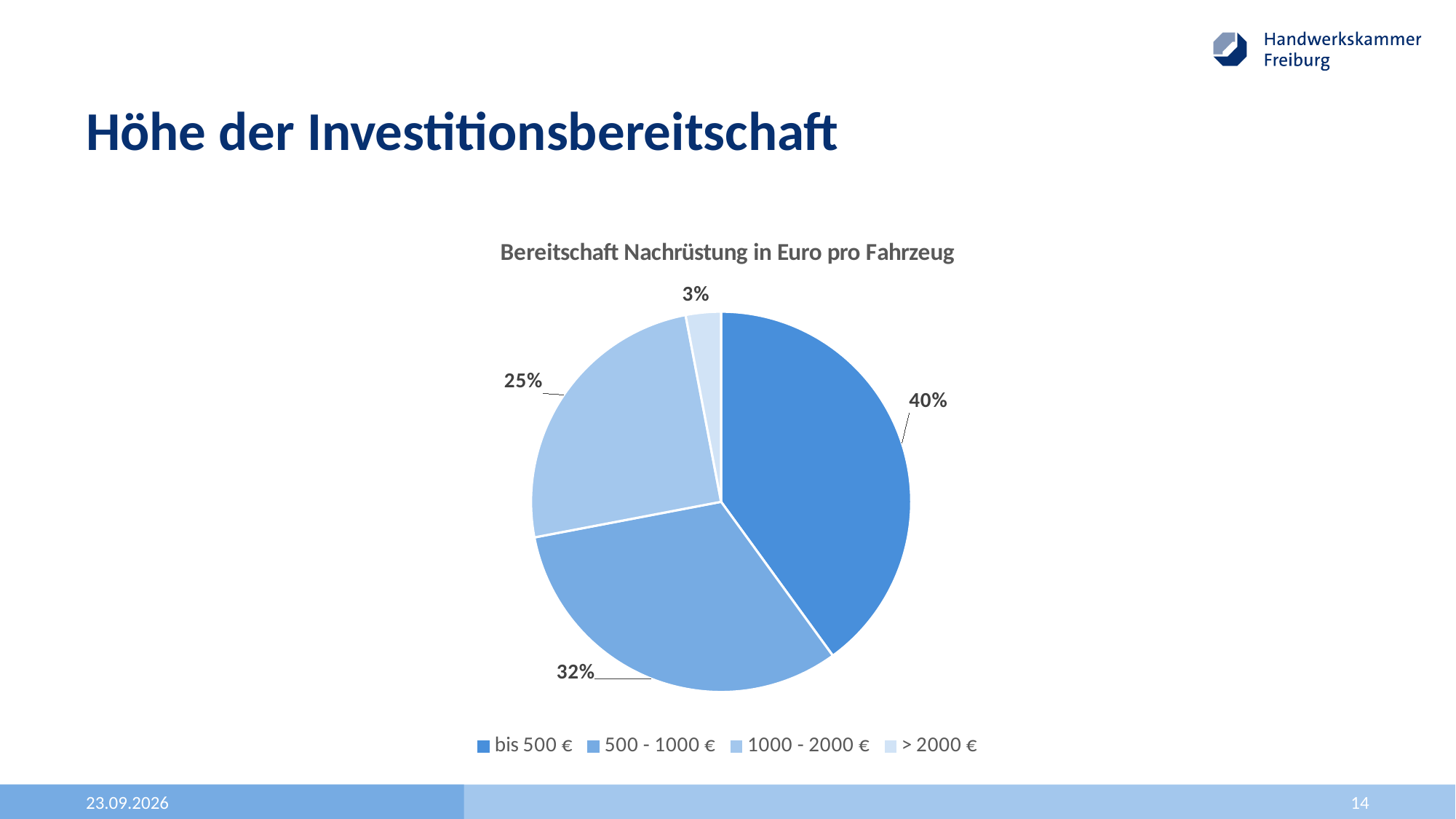
How many entries does the legend list? 4 What share of the pie does the '500 - 1000 €' slice represent? 32% Which category has the largest share of the pie? bis 500 € How many categories does the pie chart show? 4 Which slice is larger: '1000 - 2000 €' or '> 2000 €'? 1000 - 2000 € What share of the pie does the '> 2000 €' slice represent? 3% What kind of chart is shown on the slide? pie chart What is the difference in percentage points between the 'bis 500 €' slice and the '500 - 1000 €' slice? 8 percentage points What share of the pie does the 'bis 500 €' slice represent? 40% Which category has the smallest share of the pie? > 2000 € What is the title of the chart? Bereitschaft Nachrüstung in Euro pro Fahrzeug